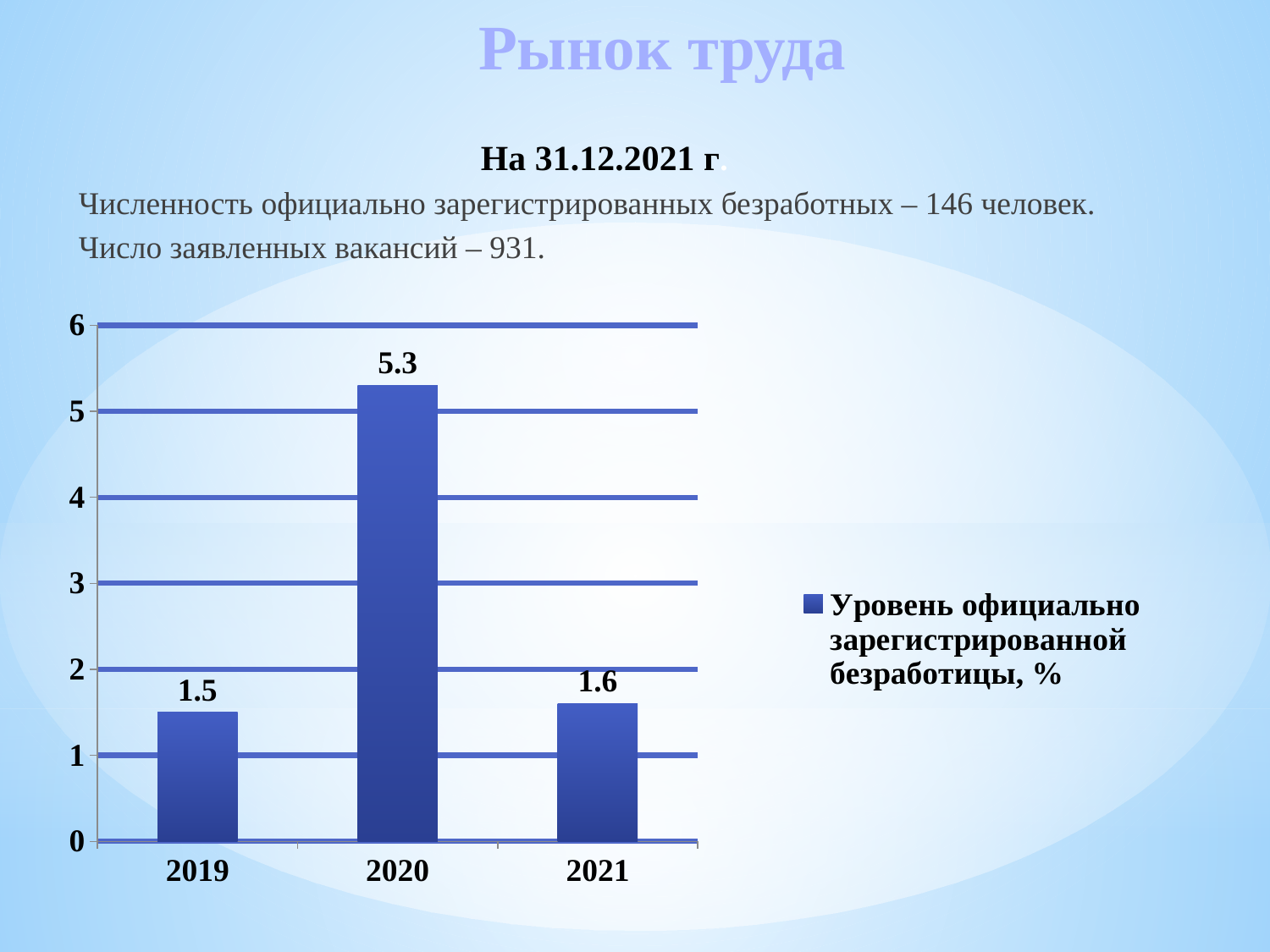
Is the value for 2020 greater or less than 5? greater What is the difference between the values for 2020 and 2021? 3.7 How many years are shown on the x axis? 3 What kind of chart is shown on the slide? bar chart What series does the legend list? Уровень официально зарегистрированной безработицы, % What is the value for 2021? 1.6 Which year has the highest value? 2020 What is the value for 2019? 1.5 Which is larger, the value for 2020 or the value for 2019? 2020 What is the value for 2020? 5.3 Which year has the lowest value? 2019 What is the difference between the values for 2021 and 2019? 0.1